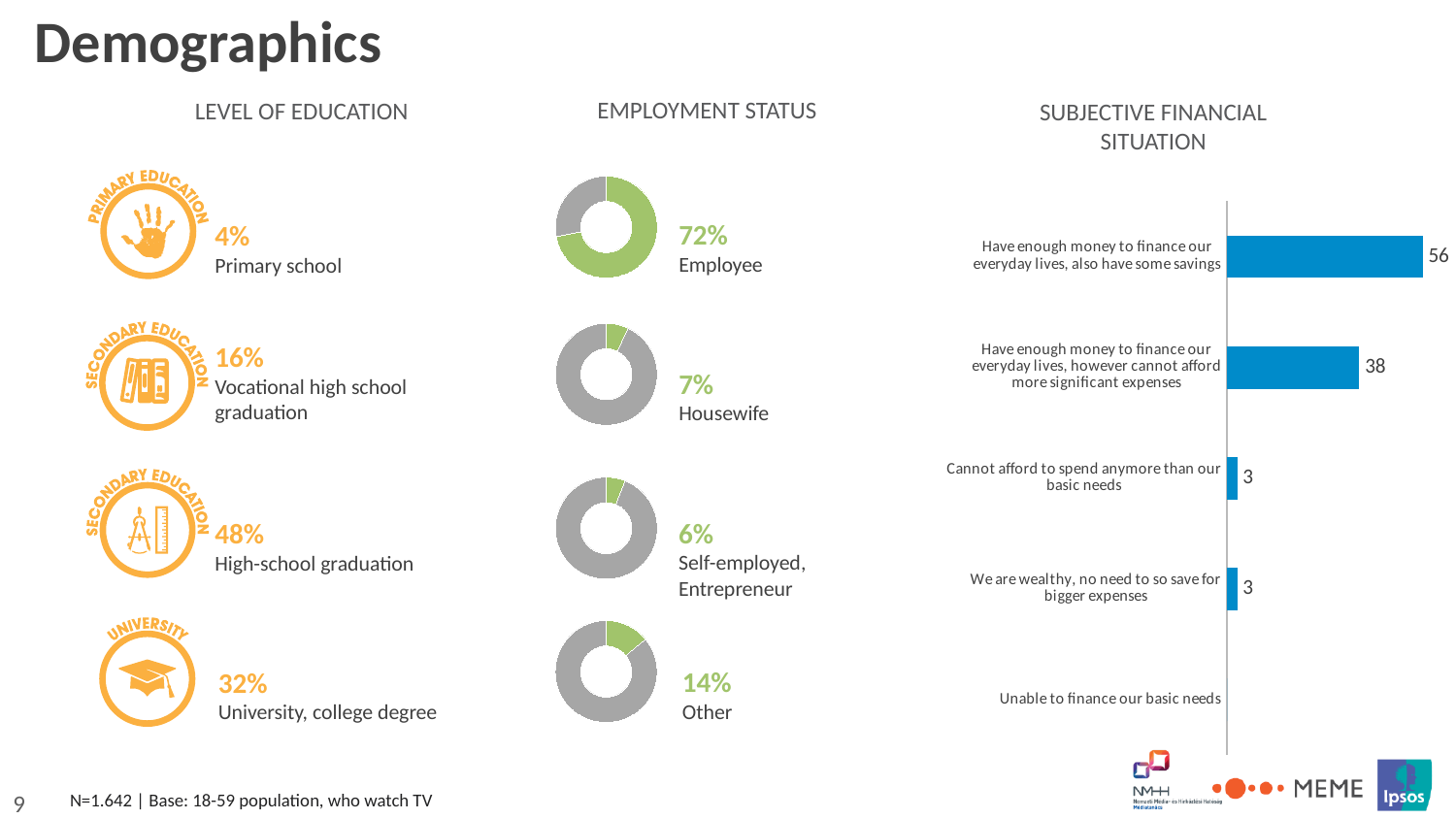
In the Subjective Financial Situation chart, what is the value for "Cannot afford to spend anymore than our basic needs"? 3 How many categories are shown in the Subjective Financial Situation chart? 5 In the Employment Status section, what percentage is shown for Other? 14% In the Subjective Financial Situation chart, what is the difference between the values for "also have some savings" and "cannot afford more significant expenses"? 18 In the Subjective Financial Situation chart, what is the value for "Have enough money to finance our everyday lives, however cannot afford more significant expenses"? 38 In the Employment Status section, what percentage is shown for Employee? 72% In the Subjective Financial Situation chart, which category has the highest value? Have enough money to finance our everyday lives, also have some savings In the Employment Status section, what percentage is shown for Housewife? 7% In the Subjective Financial Situation chart, which is larger: "Have enough money to finance our everyday lives, also have some savings" or "Have enough money to finance our everyday lives, however cannot afford more significant expenses"? Have enough money to finance our everyday lives, also have some savings What kind of chart is the Subjective Financial Situation chart? bar chart In the Subjective Financial Situation chart, what is the value for "Have enough money to finance our everyday lives, also have some savings"? 56 In the Employment Status section, which category has the highest percentage? Employee